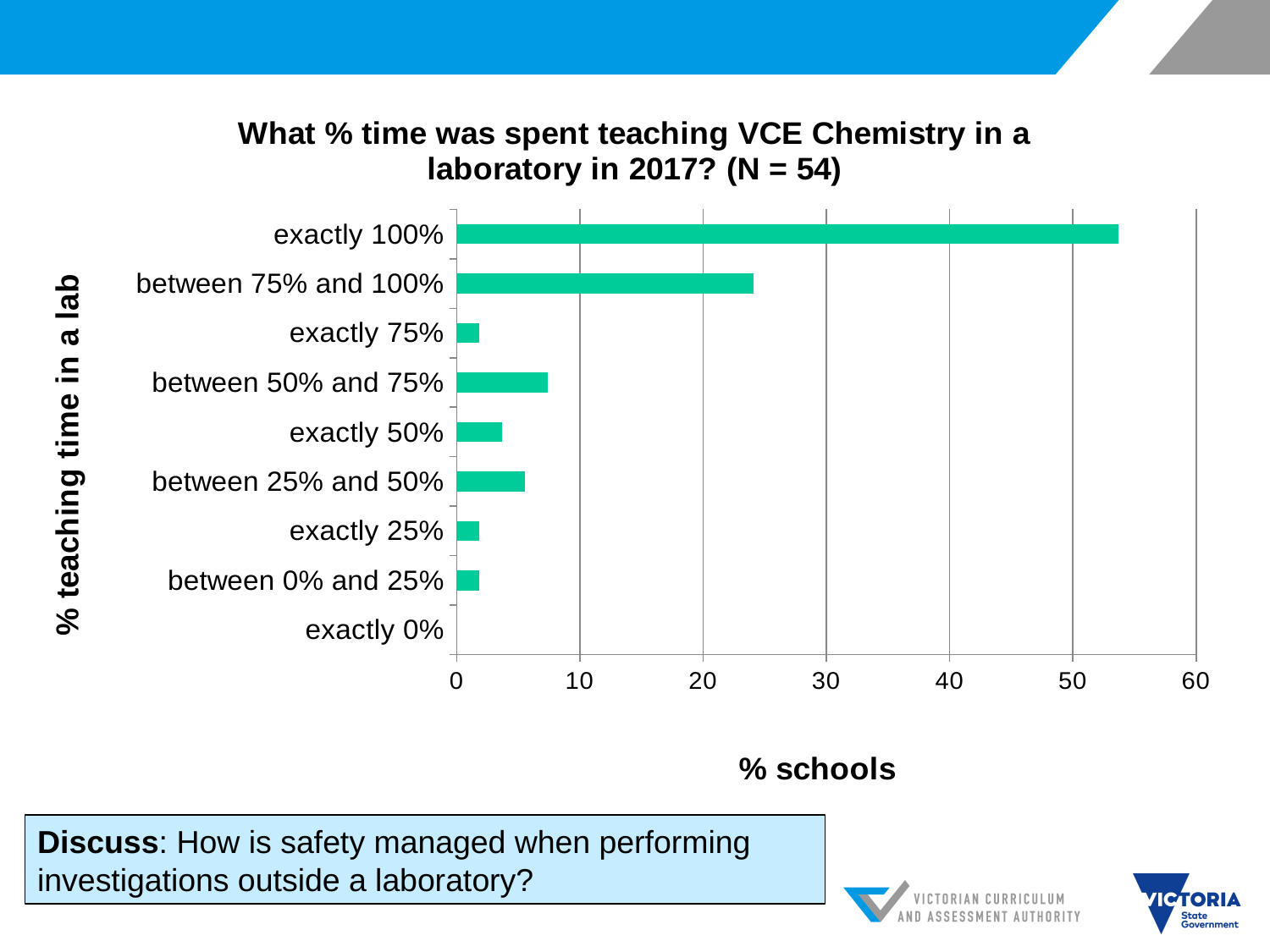
What kind of chart is shown on the slide? bar chart What is the label of the horizontal axis of the chart? % schools Which has a larger % of schools: 'between 75% and 100%' or 'between 50% and 75%'? between 75% and 100% Which category has the lowest % of schools? exactly 0% Is the value for 'between 75% and 100%' greater or less than 20? greater Which category has the highest % of schools? exactly 100% Is the value for 'between 50% and 75%' greater or less than 10? less How many categories of teaching time in a lab are shown on the chart? 9 Is the value for 'exactly 100%' greater or less than 50? greater What sample size (N) is given in the chart title? 54 Which has a larger % of schools: 'between 50% and 75%' or 'exactly 50%'? between 50% and 75%